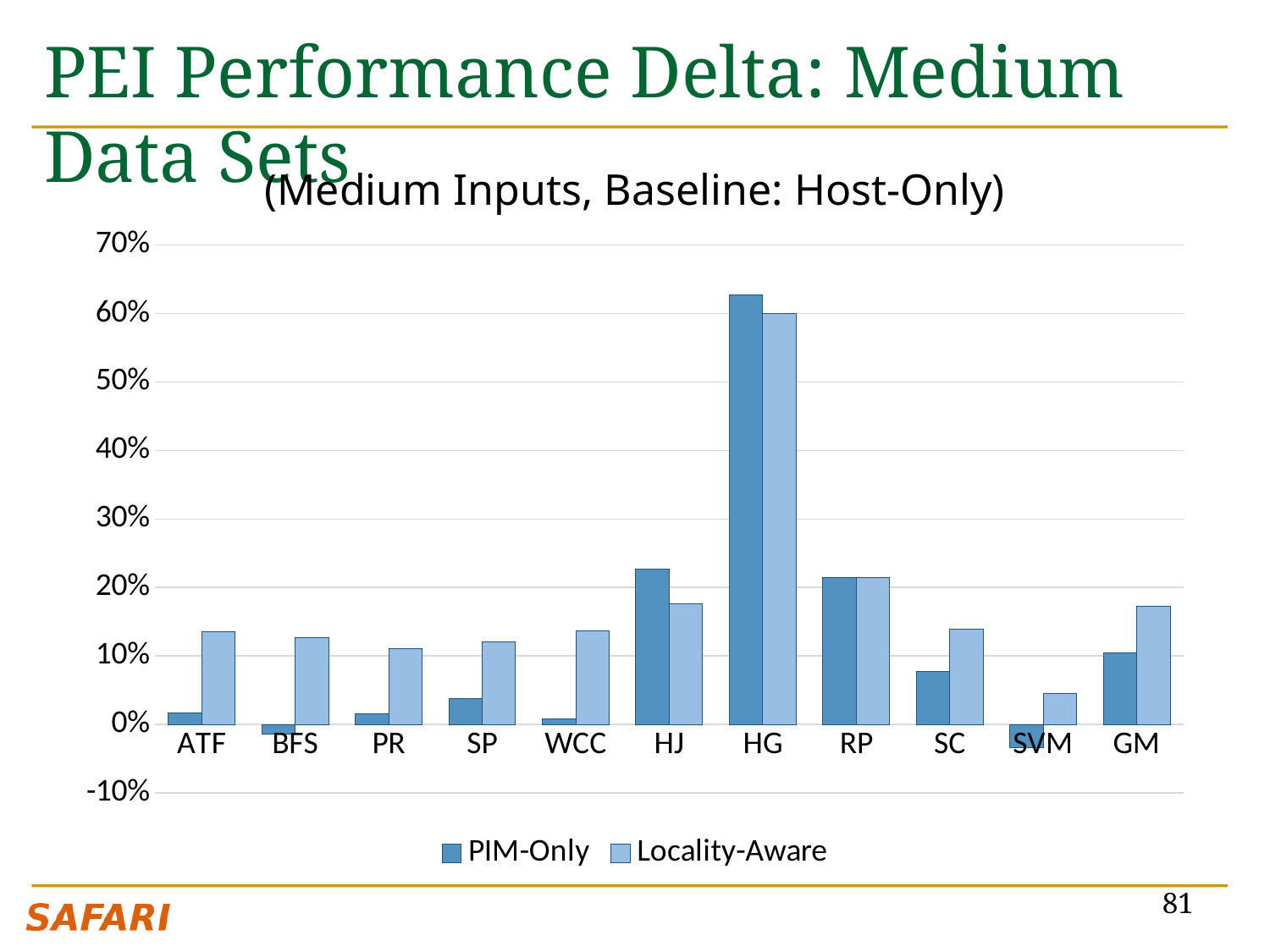
What kind of chart is shown on the slide? bar chart How many series does the legend list? 2 Which category has the highest PIM-Only value? HG For HJ, which series has the larger value, PIM-Only or Locality-Aware? PIM-Only Is the PIM-Only value for SP greater or less than 10%? less How many categories are shown on the x axis? 11 Which category has the highest Locality-Aware value? HG What are the two series named in the legend? PIM-Only and Locality-Aware Is the Locality-Aware value for GM greater or less than 20%? less For ATF, which series has the larger value, PIM-Only or Locality-Aware? Locality-Aware Which category has the lowest Locality-Aware value? SVM Is the PIM-Only value for HG greater or less than 50%? greater